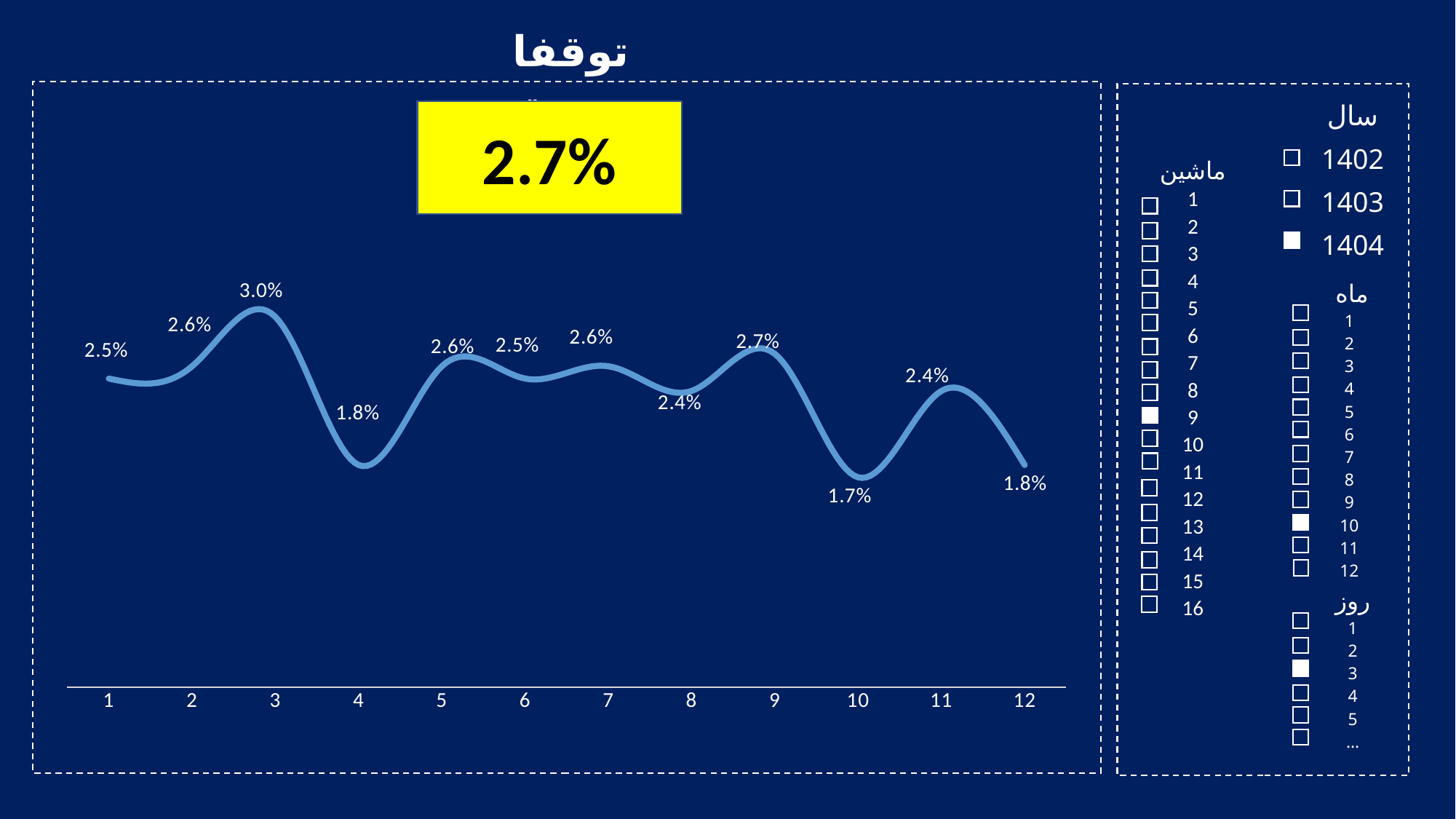
What is the value at point 12 on the line chart? 1.8% What is the difference between the values at point 3 and point 4? 1.2% Which point on the x axis has the highest value? 3 Does the line rise or fall from point 9 to point 10? fall What is the value at point 9 on the line chart? 2.7% What value is shown in the yellow box above the chart? 2.7% What kind of chart is shown on the slide? line chart What is the value at point 10 on the line chart? 1.7% Which is larger, the value at point 1 or the value at point 4? point 1 How many points are plotted on the line chart? 12 Which point on the x axis has the lowest value? 10 What is the value at point 3 on the line chart? 3.0%